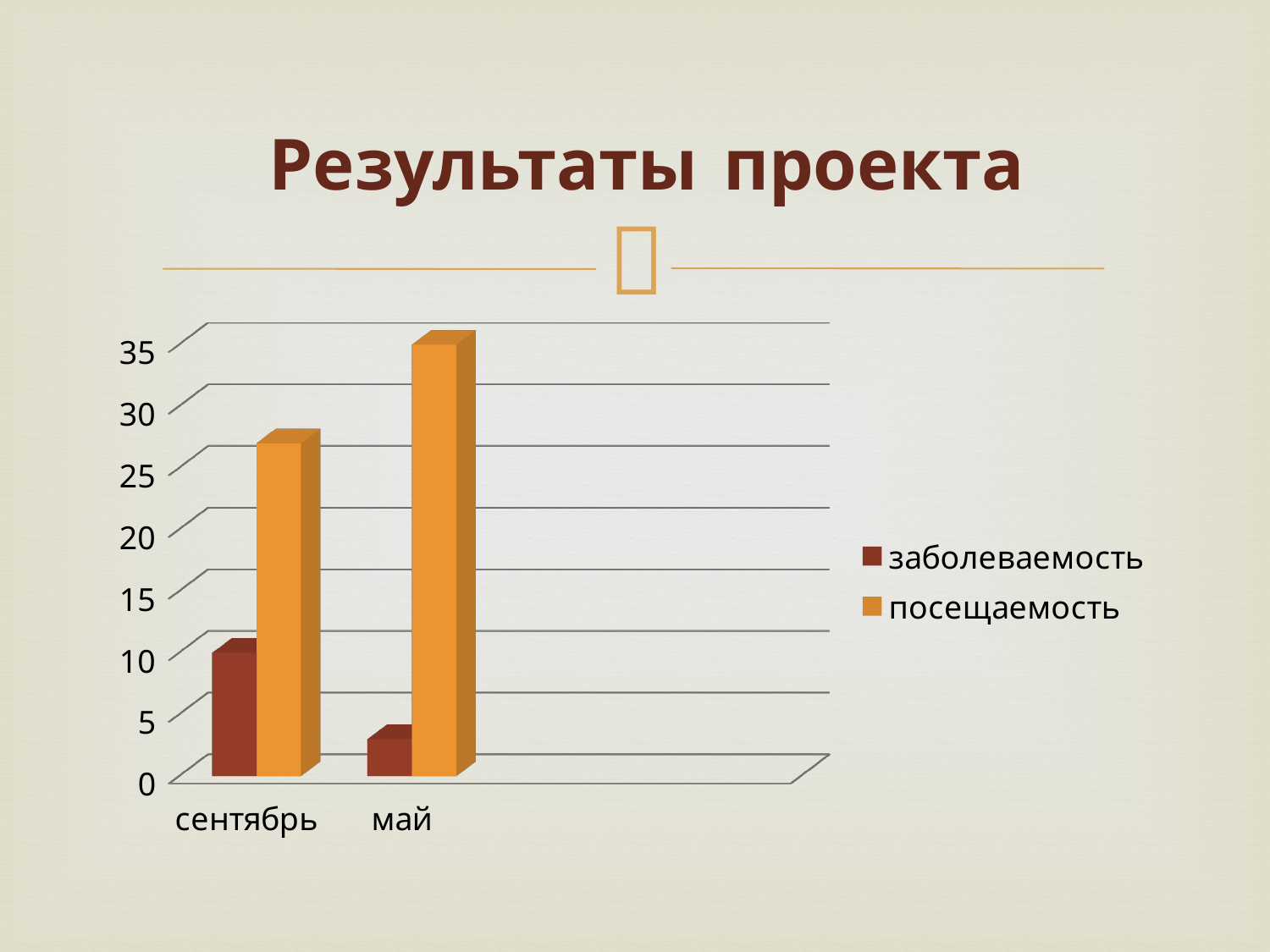
Is the value of посещаемость for май greater or less than 30? greater What kind of chart is shown on the slide? bar chart Which category has the lower value for заболеваемость? май Which series is shown in orange in the legend? посещаемость What is the title of the slide with the chart? Результаты проекта How many series does the legend list? 2 Is the value of заболеваемость for май greater or less than 5? less Is the value of заболеваемость for сентябрь greater or less than 5? greater How many categories are shown on the x axis? 2 Does посещаемость rise or fall from сентябрь to май? rise Which category has the higher value for посещаемость, сентябрь or май? май